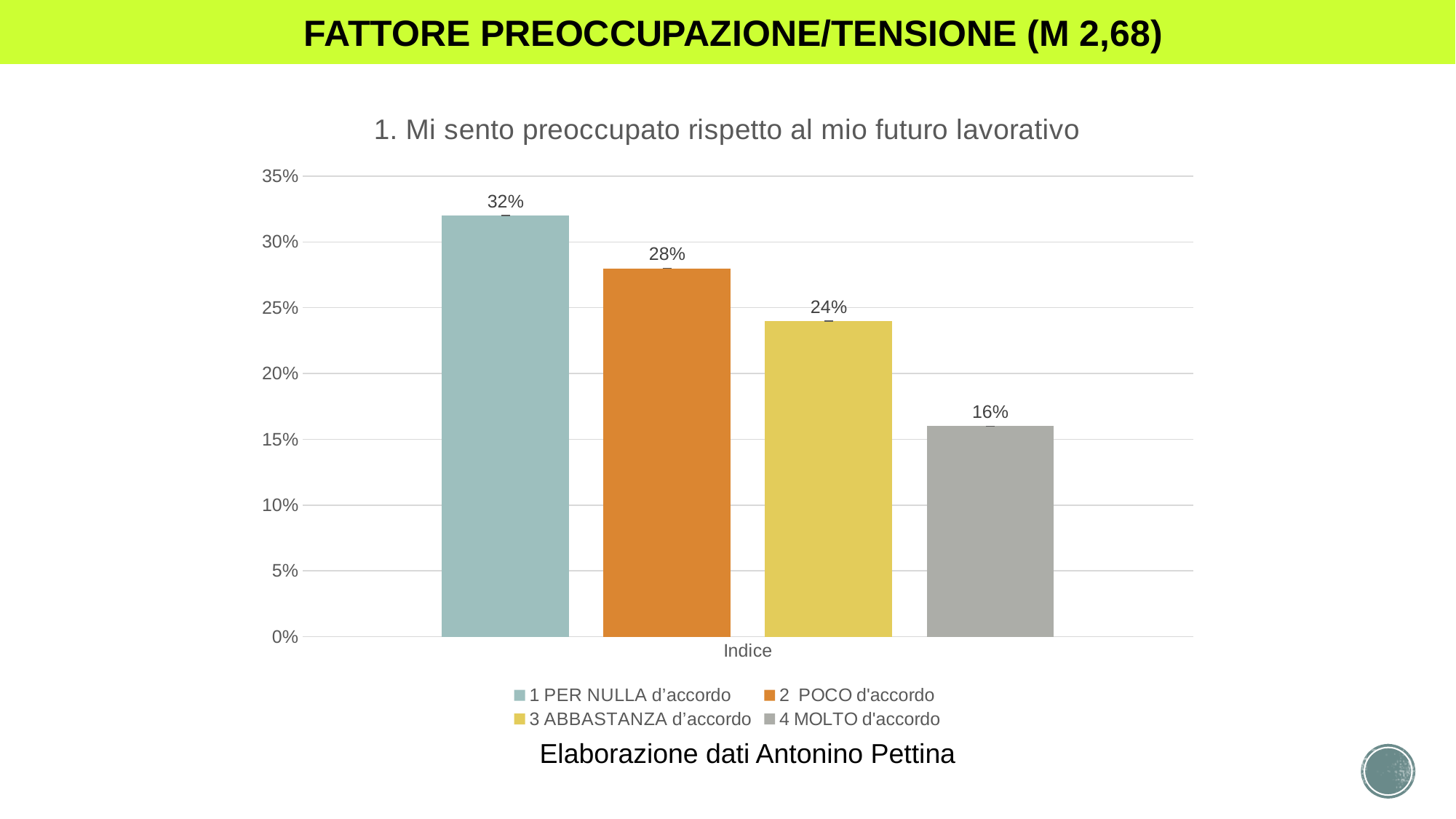
What kind of chart is shown on the slide? Bar chart What is the value for "3 ABBASTANZA d'accordo"? 24% What is the label on the x axis of the chart? Indice What is the title of the chart? 1. Mi sento preoccupato rispetto al mio futuro lavorativo What is the value for "1 PER NULLA d'accordo"? 32% Which is larger, the value for "2 POCO d'accordo" or "3 ABBASTANZA d'accordo"? 2 POCO d'accordo What is the value for "2 POCO d'accordo"? 28% How many series does the legend list? 4 What is the difference between the values for "1 PER NULLA d'accordo" and "4 MOLTO d'accordo"? 16% Which series has the lowest value? 4 MOLTO d'accordo Which series has the highest value? 1 PER NULLA d'accordo What is the value for "4 MOLTO d'accordo"? 16%